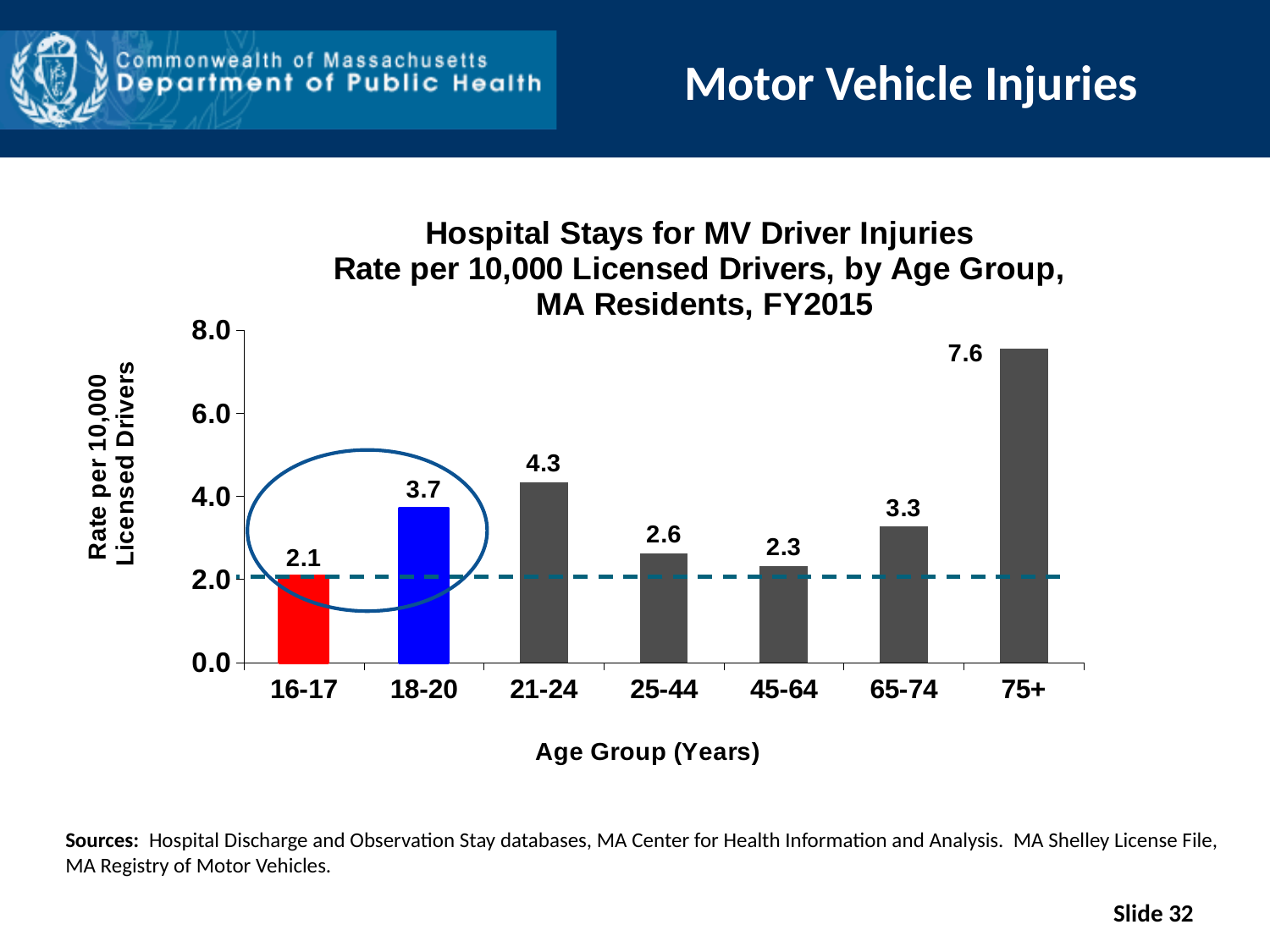
What is the label of the x axis? Age Group (Years) What is the rate per 10,000 licensed drivers for the 75+ age group? 7.6 What is the difference between the rates for the 75+ and 21-24 age groups? 3.3 What is the rate per 10,000 licensed drivers for the 45-64 age group? 2.3 Which age group has the highest rate of hospital stays for MV driver injuries? 75+ What is the rate per 10,000 licensed drivers for the 18-20 age group? 3.7 Is the value for the 21-24 age group greater or less than 4.0? greater Which age group has a higher rate, 25-44 or 65-74? 65-74 What is the difference between the rates for the 18-20 and 16-17 age groups? 1.6 What kind of chart is shown on the slide? Bar chart Which age group has the lowest rate of hospital stays for MV driver injuries? 16-17 How many age groups are shown on the x axis? 7